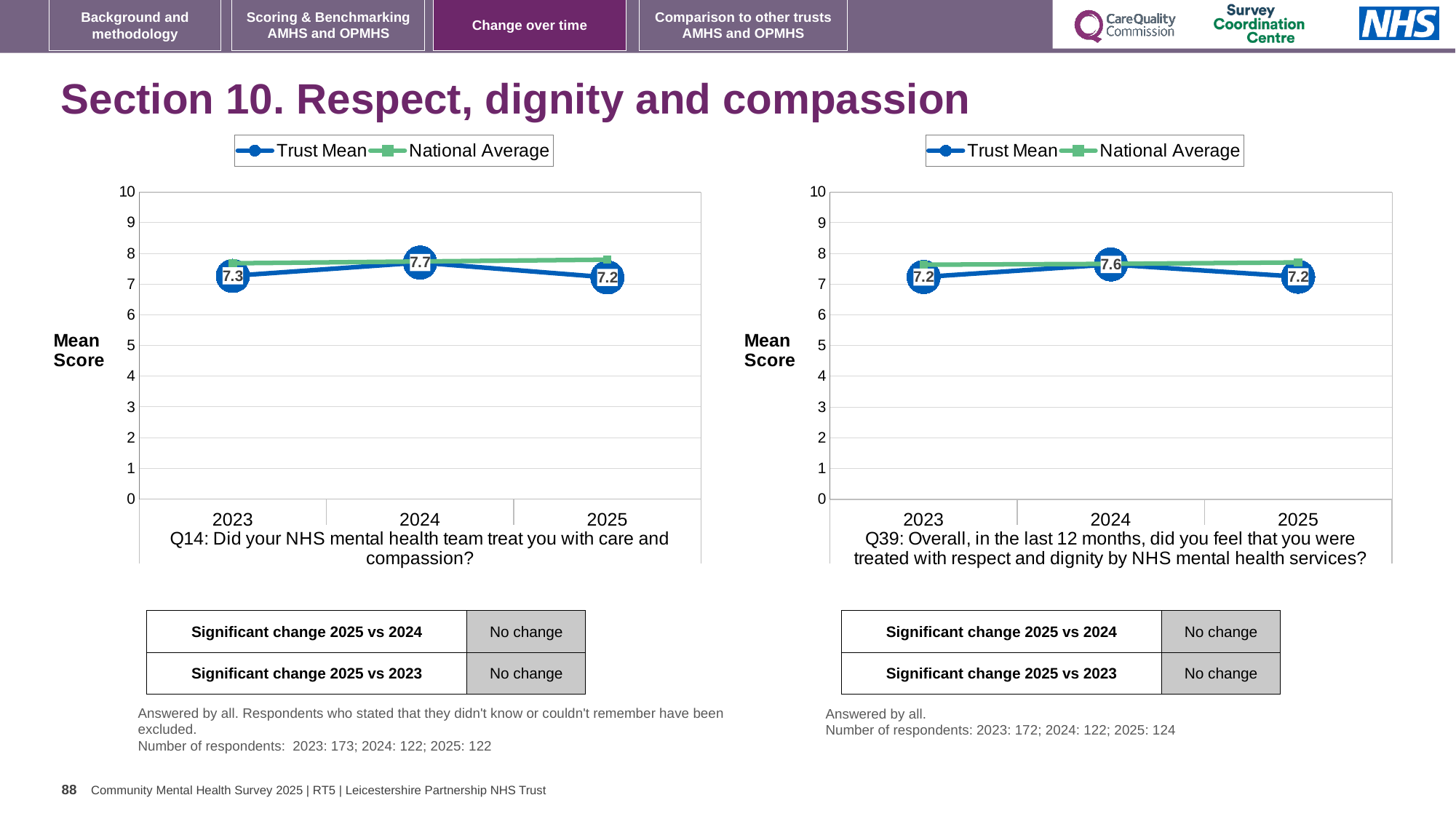
In the Q39 chart on the right, what is the Trust Mean for 2023? 7.2 What kind of chart is the Q14 chart on the left? Line chart In the Q14 chart on the left, what is the Trust Mean for 2024? 7.7 In the Q14 chart on the left, what is the difference between the Trust Mean for 2024 and the Trust Mean for 2025? 0.5 In the Q39 chart on the right, which year has the highest Trust Mean? 2024 In the Q39 chart on the right, what is the difference between the Trust Mean for 2024 and the Trust Mean for 2023? 0.4 In the Q14 chart on the left, which year has the highest Trust Mean? 2024 How many series does the legend of the Q39 chart on the right list? 2 In the Q14 chart on the left, which year has the lowest Trust Mean? 2025 In the Q14 chart on the left, is the National Average for 2025 greater or less than 7? greater In the Q39 chart on the right, what is the Trust Mean for 2024? 7.6 In the Q14 chart on the left, what is the Trust Mean for 2025? 7.2